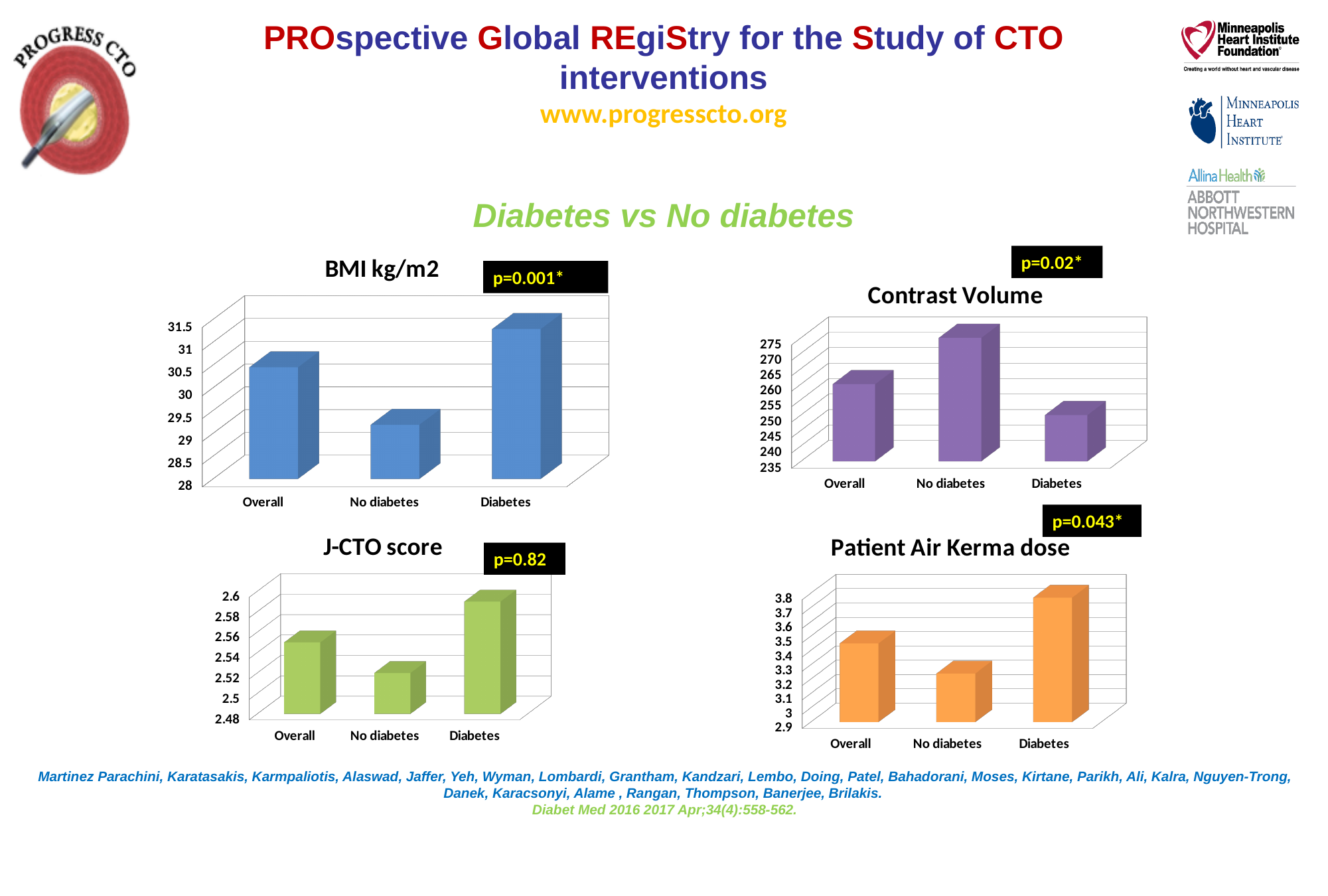
In the BMI kg/m2 chart, which category has the highest value? Diabetes In the J-CTO score chart, which is larger, the value for Overall or the value for Diabetes? Diabetes What kind of chart is the Patient Air Kerma dose chart? Bar chart In the J-CTO score chart, which category has the lowest value? No diabetes In the Contrast Volume chart, which category has the highest value? No diabetes In the Contrast Volume chart, is the value for No diabetes greater or less than 270? greater In the Contrast Volume chart, which category has the lowest value? Diabetes In the Patient Air Kerma dose chart, which category has the highest value? Diabetes In the BMI kg/m2 chart, which category has the lowest value? No diabetes In the BMI kg/m2 chart, is the value for No diabetes greater or less than 30? less In the Patient Air Kerma dose chart, is the value for No diabetes greater or less than 3.4? less How many categories are shown in the Contrast Volume chart? 3